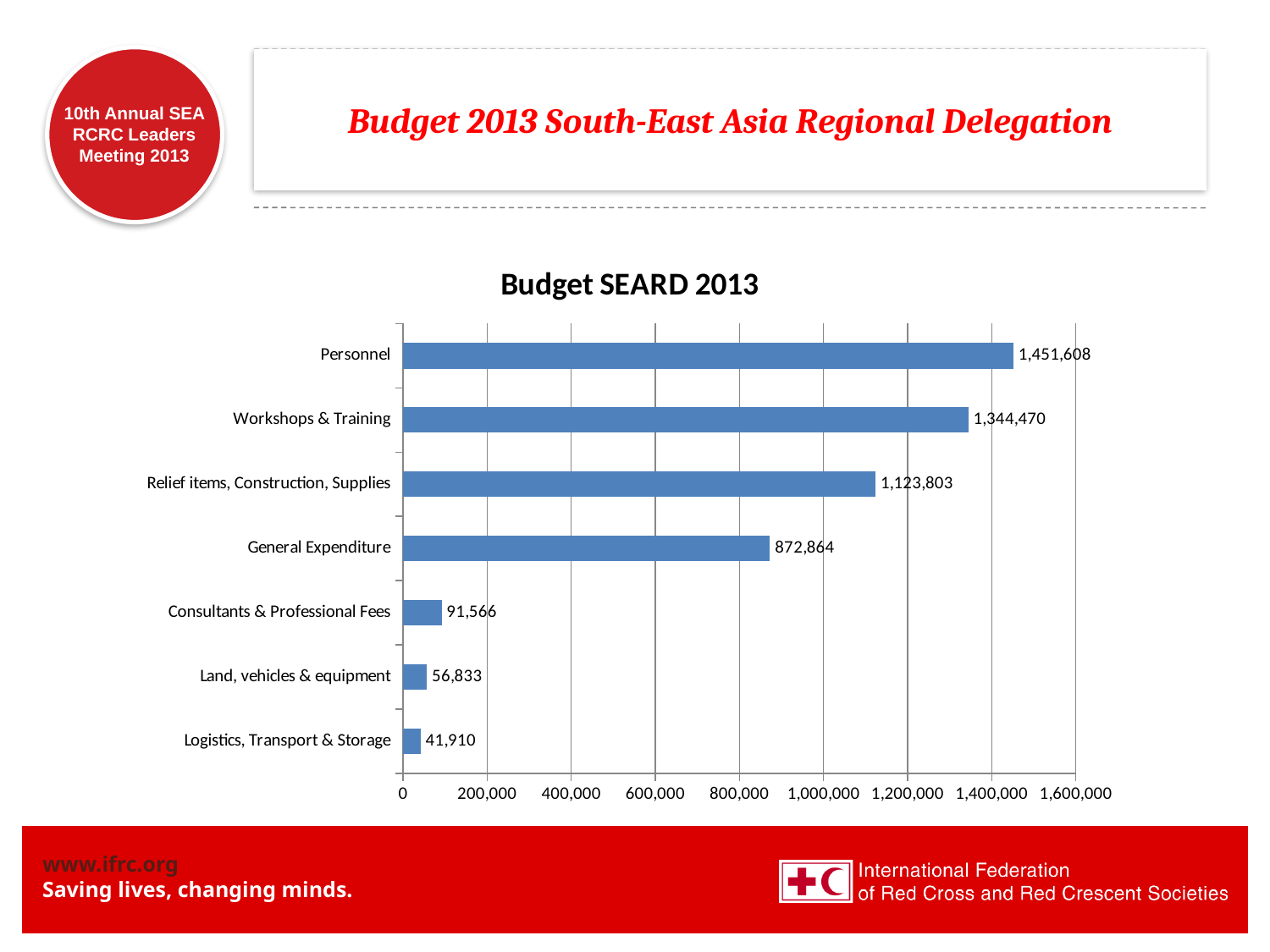
How many categories are shown in the chart? 7 Is the value for General Expenditure greater or less than 1,000,000? less What kind of chart is shown on the slide? Bar chart Which is larger, General Expenditure or Consultants & Professional Fees? General Expenditure Which category has the highest budget value? Personnel What is the value shown for Workshops & Training? 1,344,470 What is the value shown for Relief items, Construction, Supplies? 1,123,803 What is the value shown for Logistics, Transport & Storage? 41,910 What is the budget value for Personnel in the Budget SEARD 2013 chart? 1,451,608 What is the difference between the Land, vehicles & equipment value and the Logistics, Transport & Storage value? 14,923 What is the difference between the Personnel value and the Workshops & Training value? 107,138 Which category has the lowest budget value? Logistics, Transport & Storage